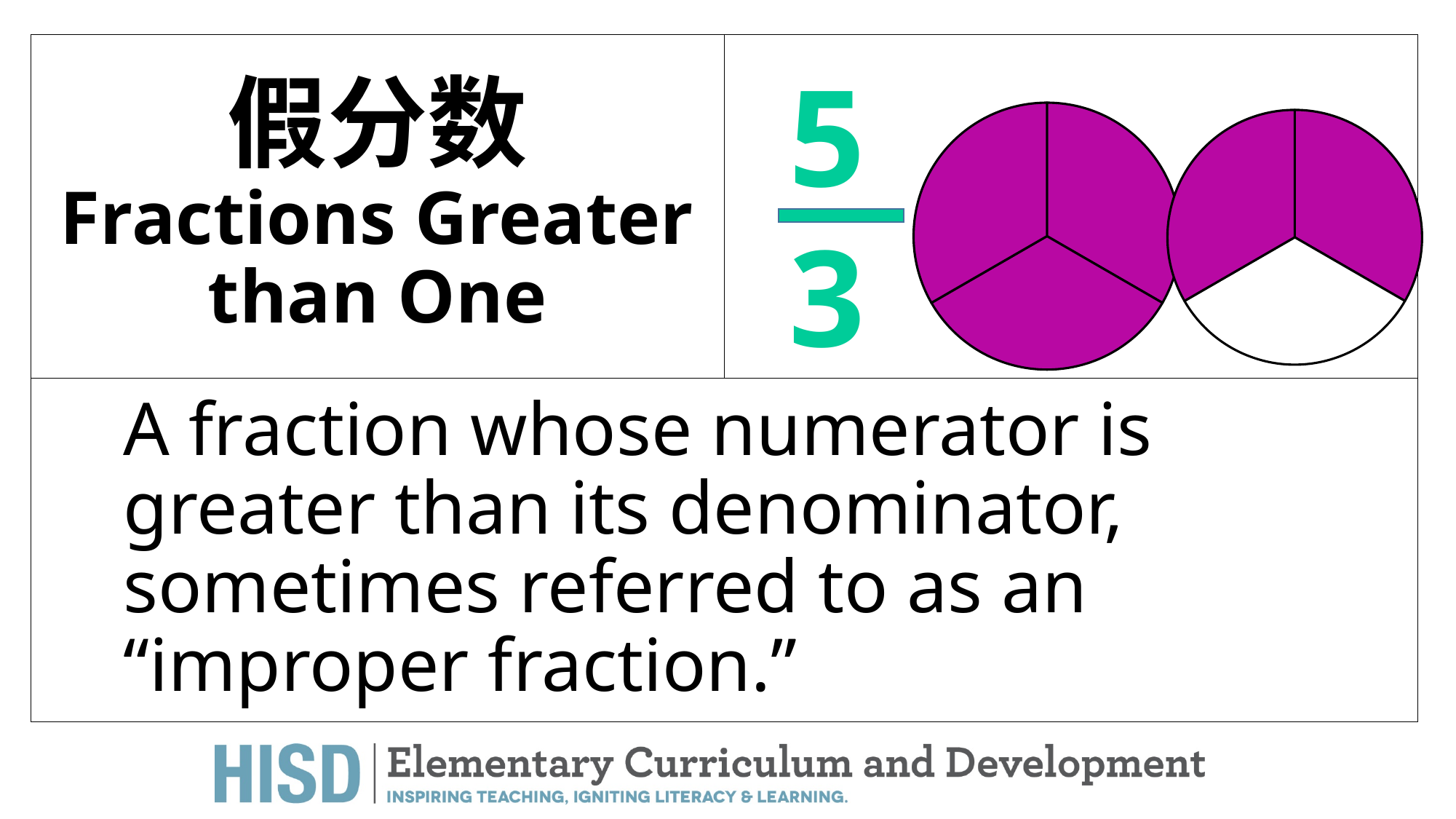
How many parts are shaded purple across both circles? 5 What colour are the shaded parts of the circles? Purple Into how many equal parts is each circle divided? 3 How many circles are drawn on the slide? 2 Which circle has more shaded parts, the left or the right? Left What fraction is shown next to the circle diagrams? 5/3 Is the left-hand circle fully shaded? Yes What is the denominator of the fraction shown? 3 What is the numerator of the fraction shown? 5